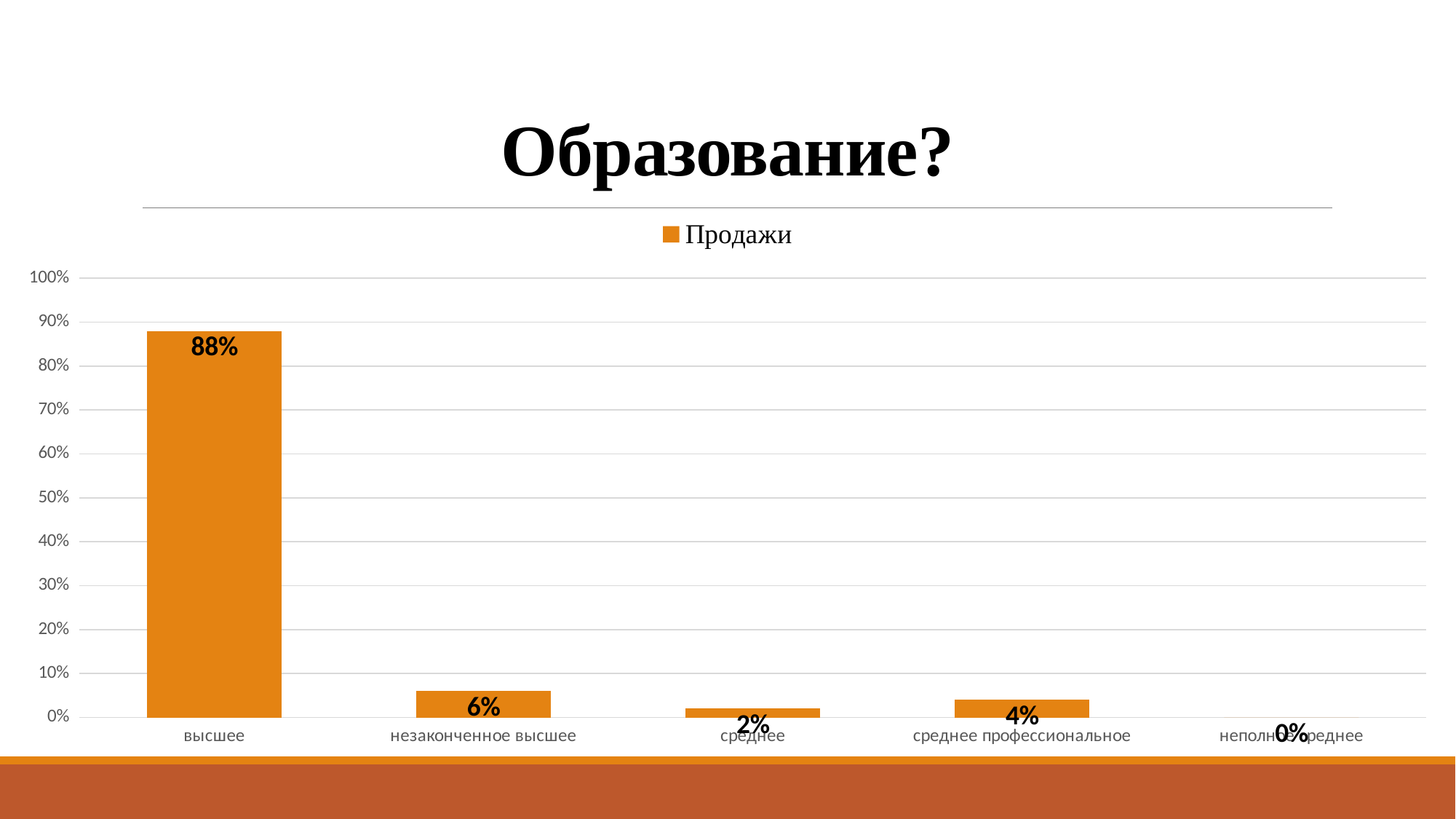
Which is larger, the value for среднее профессиональное or the value for среднее? среднее профессиональное Which category has the highest value? высшее What is the value for высшее? 88% What is the value for среднее профессиональное? 4% How many categories are shown on the x axis? 5 What kind of chart is shown on the slide? bar chart What is the value for среднее? 2% What series name does the legend show? Продажи What is the difference between the values for высшее and незаконченное высшее? 82% Which category has the lowest value? неполное среднее What is the value for незаконченное высшее? 6% Is the value for высшее greater or less than 80%? greater